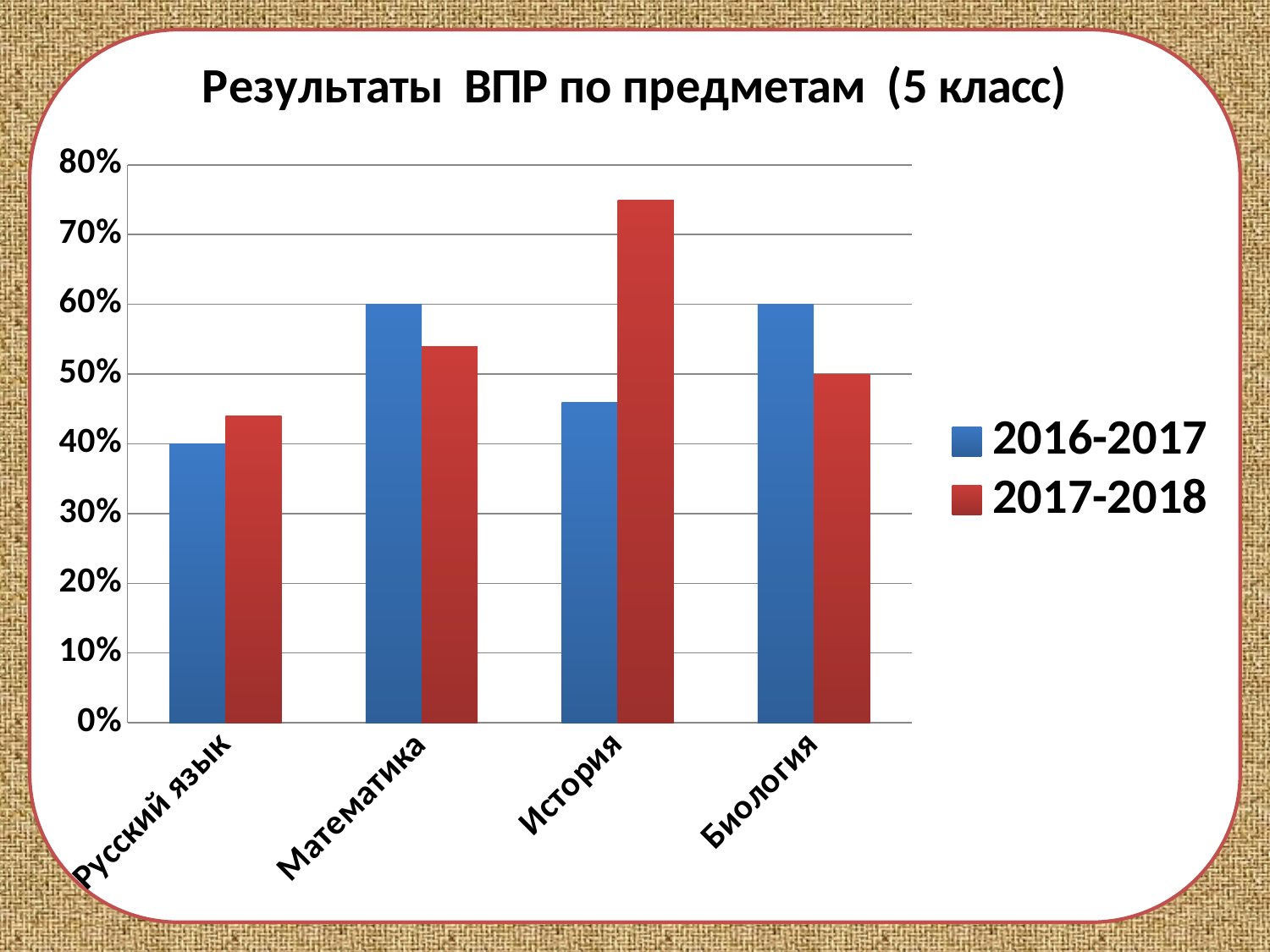
What is the title of the chart? Результаты ВПР по предметам (5 класс) For Математика, which series has the larger value, 2016-2017 or 2017-2018? 2016-2017 What kind of chart is shown on the slide? bar chart What is the value for Математика in the 2016-2017 series? 60% How many subjects (categories) are shown on the x axis? 4 What is the value for Биология in the 2017-2018 series? 50% Which subject has the highest value in the 2017-2018 series? История What is the value for Русский язык in the 2016-2017 series? 40% Is the 2017-2018 value for История greater or less than 70%? greater How many series does the legend list? 2 Which subject has the lowest value in the 2016-2017 series? Русский язык What is the difference between the 2016-2017 and 2017-2018 values for Биология? 10%